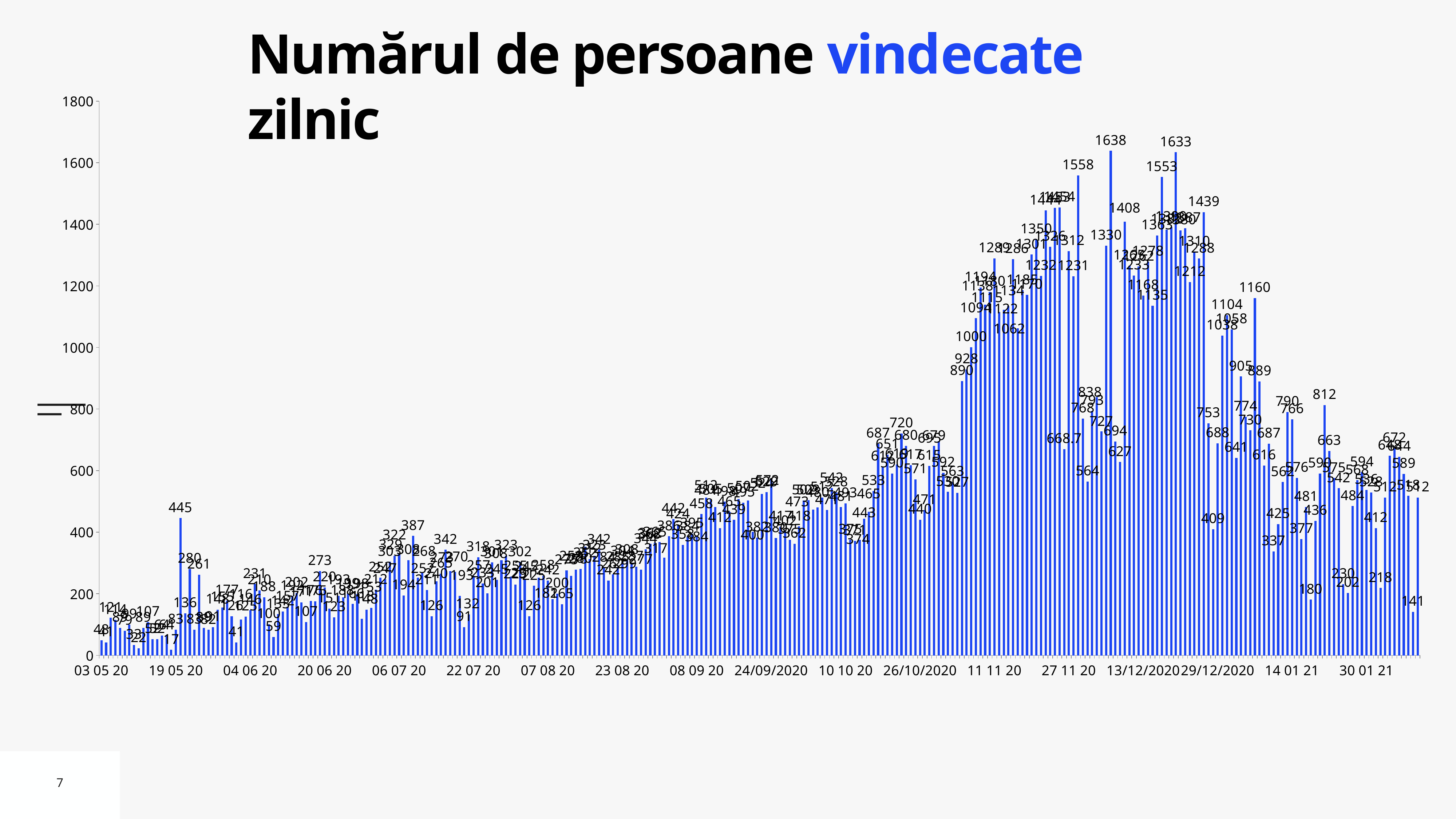
Do the values generally rise or fall from 03 05 20 to 11 11 20? rise What is the value of the tallest bar between the 29/12/2020 and 14 01 21 ticks? 1160 What is the difference between the two highest bars, 1638 and 1633? 5 Is the tallest bar on the chart greater or less than 1600? greater What is the value of the tallest bar just before the 30 01 21 tick? 812 What is the value of the tall isolated bar near the 19 05 20 tick? 445 What kind of chart is shown on the slide? bar chart What is the highest value shown on the chart? 1638 What is the title of the chart? Numărul de persoane vindecate zilnic Is the isolated peak near 19 05 20 greater or less than 400? greater What is the value of the second-highest bar, labelled just to the right of the 1638 peak? 1633 What is the maximum value shown on the vertical axis? 1800